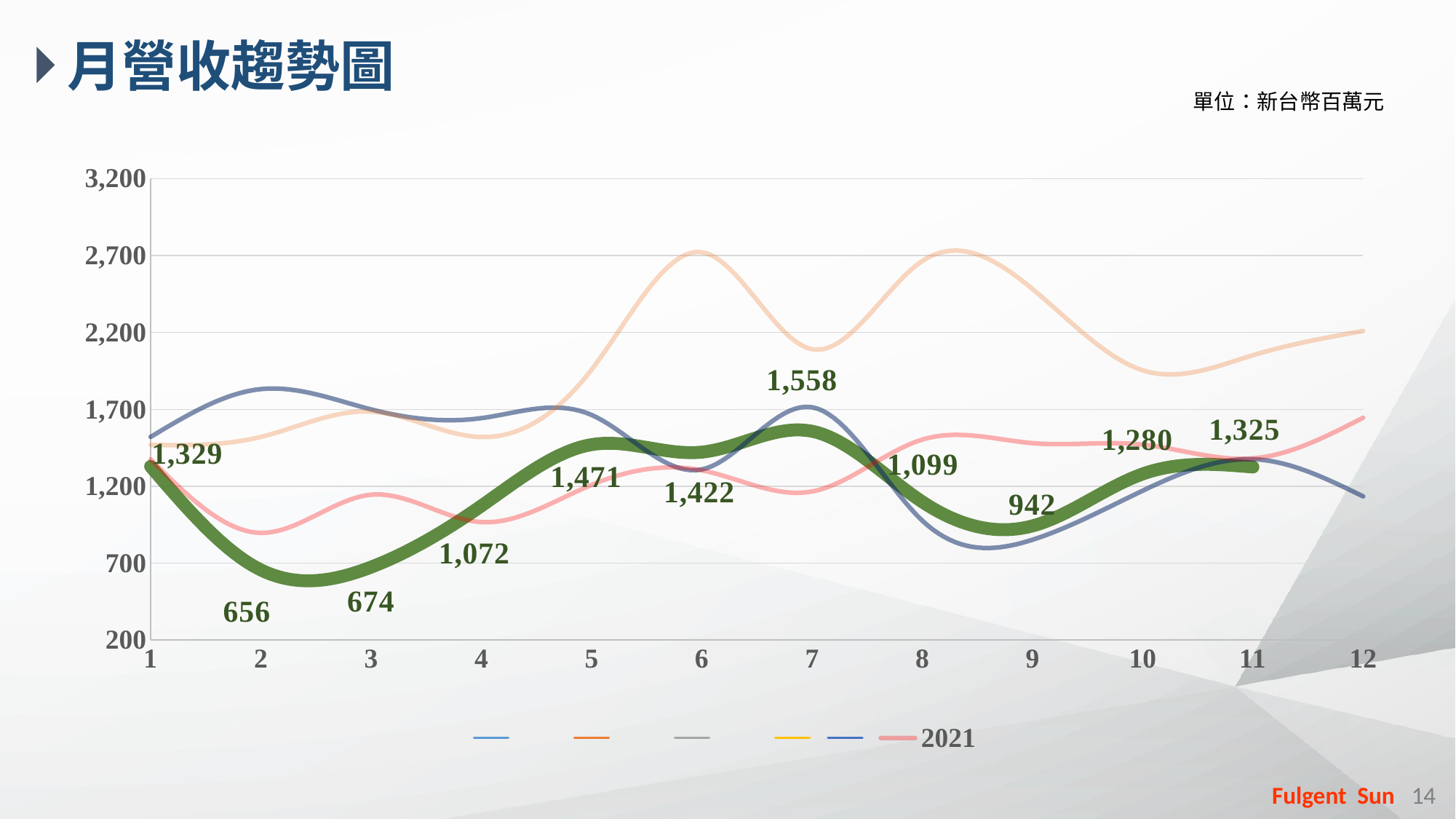
What kind of chart is shown on the slide? line chart What is the title of the chart? 月營收趨勢圖 Does the thick green line rise or fall from month 2 to month 5? rise How many months are shown on the x axis? 12 At which month does the thick green line have its lowest labelled value? 2 Is the value of the 2021 line at month 12 greater or less than 1,200? greater What is the difference between the thick green line's values at month 1 and month 2? 673 At which month does the thick green line reach its highest labelled value? 7 Which is larger on the thick green line: the value at month 10 or at month 11? month 11 What unit is stated for the values in the chart? 新台幣百萬元 What is the labelled value of the thick green line at month 2? 656 What is the labelled value of the thick green line at month 7? 1,558